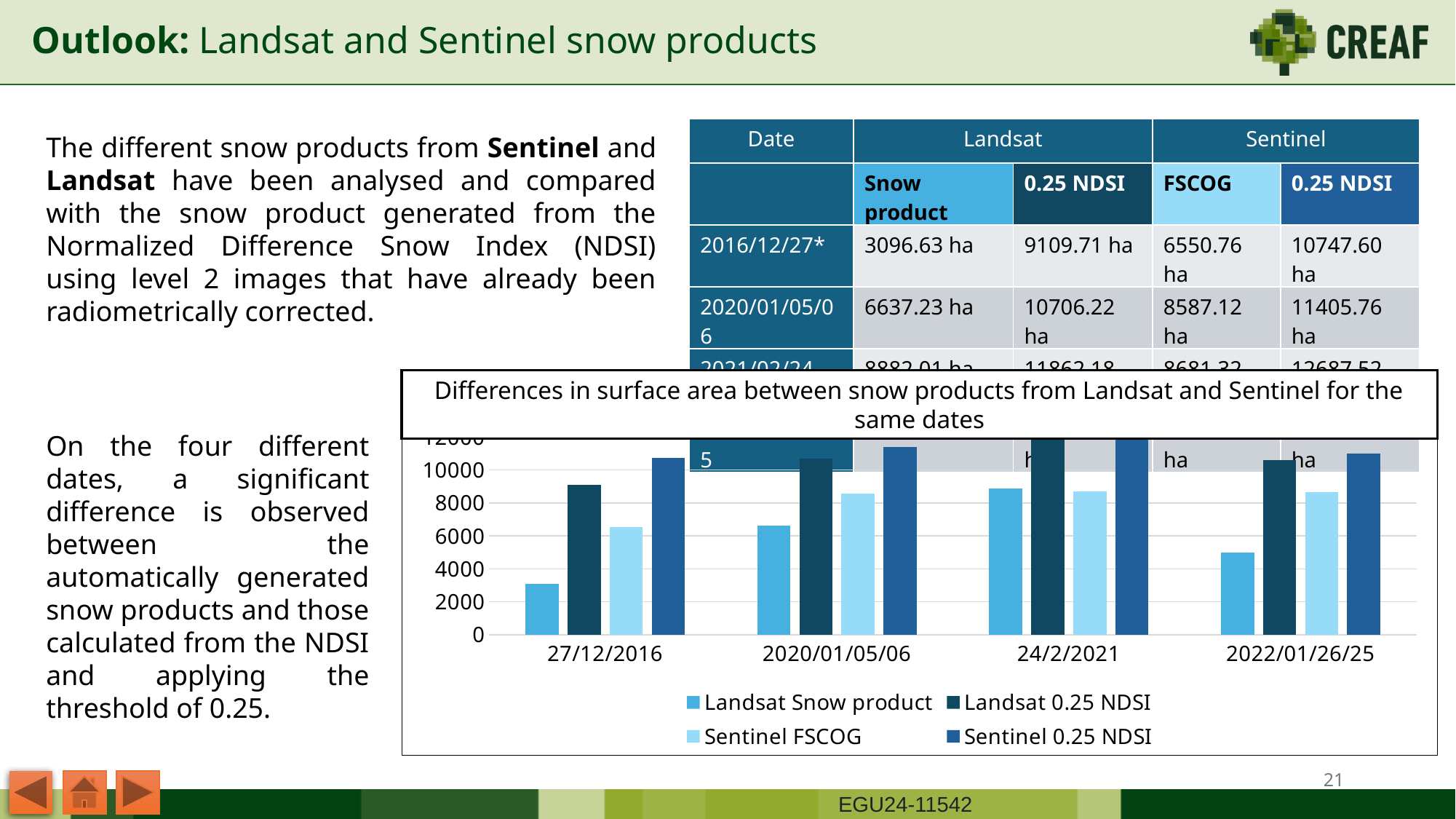
How many dates are shown on the x axis of the chart? 4 Is the value for Landsat 0.25 NDSI on 27/12/2016 greater or less than 8000? greater What is the title of the chart? Differences in surface area between snow products from Landsat and Sentinel for the same dates On 27/12/2016, which is larger: Landsat Snow product or Landsat 0.25 NDSI? Landsat 0.25 NDSI Is the value for Sentinel 0.25 NDSI on 27/12/2016 greater or less than 10000? greater On which date is the Landsat Snow product value lowest? 27/12/2016 Is the value for Landsat Snow product on 27/12/2016 greater or less than 4000? less On 24/2/2021, which is larger: Sentinel FSCOG or Sentinel 0.25 NDSI? Sentinel 0.25 NDSI Which series is shown in the darkest blue bars in the chart? Landsat 0.25 NDSI How many series does the chart legend list? 4 What kind of chart is shown on the slide? bar chart